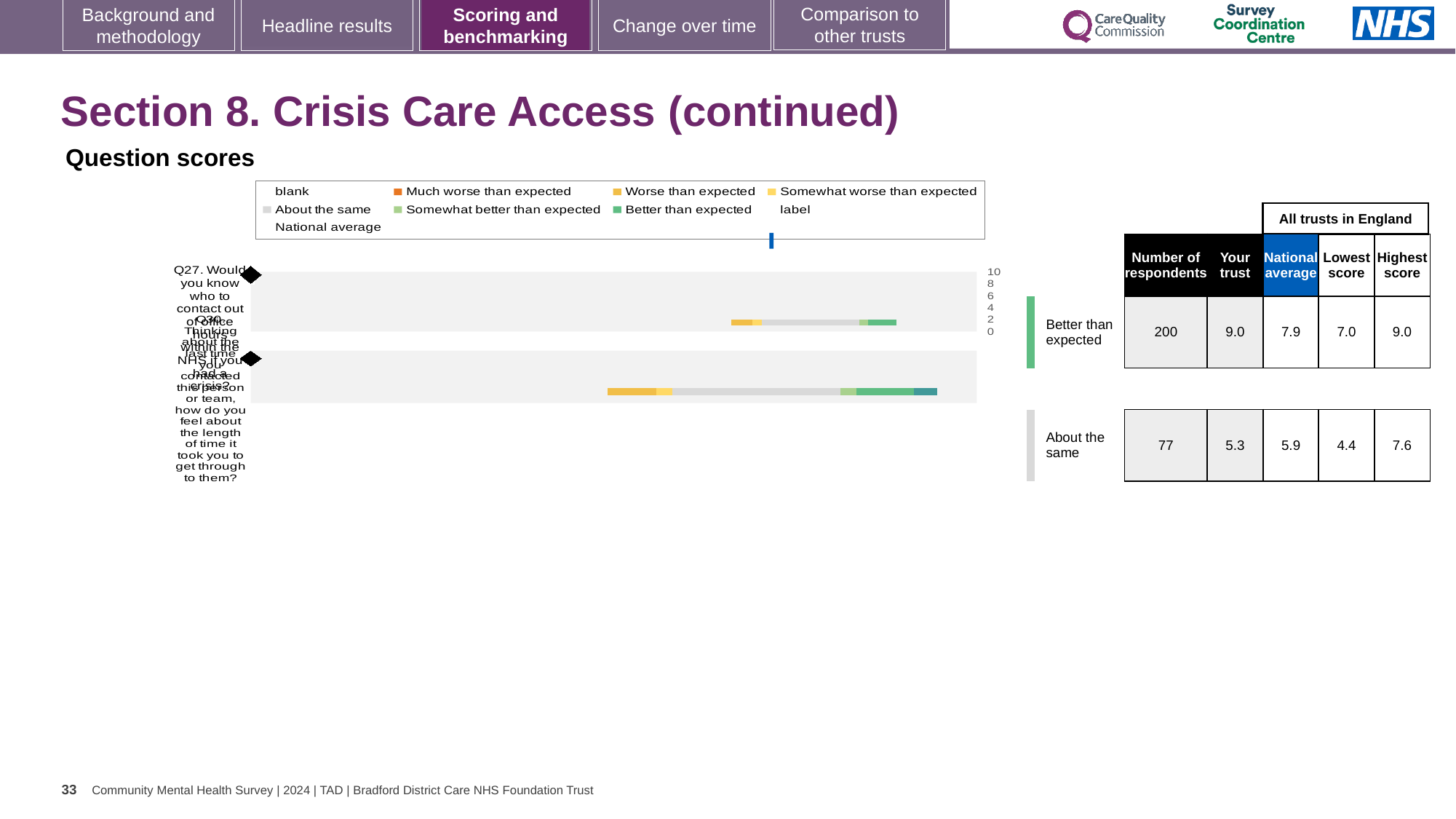
What is the national average for Q27 (the 'Better than expected' row)? 7.9 What kind of chart is used to show the question scores on this slide? Bar chart What is the highest value shown on the chart's score axis? 10 How many survey questions are plotted in the question scores chart? 2 What is the difference between the highest score and the lowest score for Q27 (the 'Better than expected' row)? 2.0 Which question has the lower number of respondents, Q27 or Q28? Q28 For Q28 (the 'About the same' row), which is larger: the 'Your trust' score or the national average? National average What is the difference between the national average and the 'Your trust' score for Q28 (the 'About the same' row)? 0.6 What is the highest score among all trusts in England for Q28 (the 'About the same' row)? 7.6 Which question has the higher 'Your trust' score, Q27 or Q28? Q27 How many respondents answered Q28 (the 'About the same' row)? 77 What is the 'Your trust' score for Q27 (the 'Better than expected' row)? 9.0